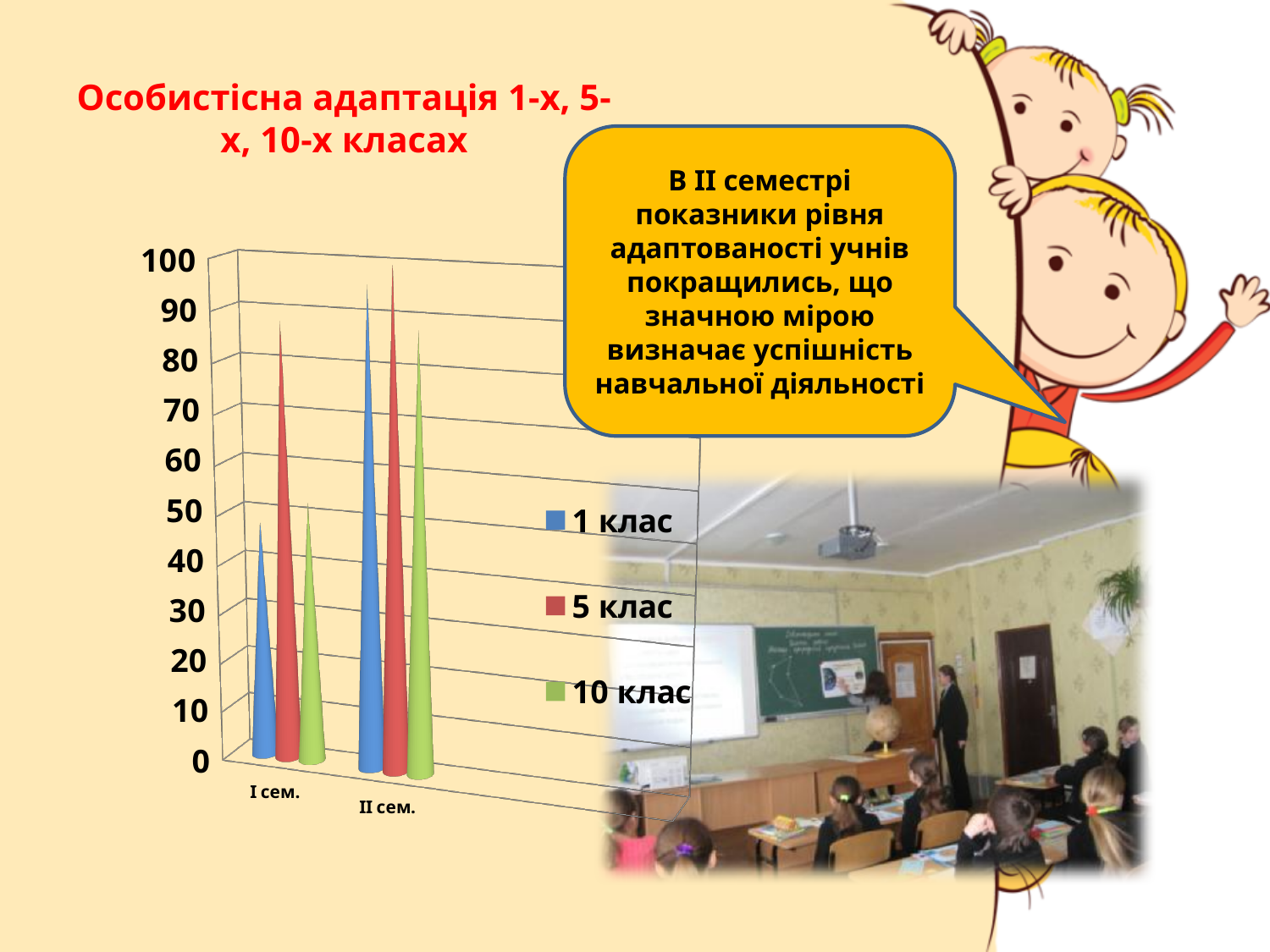
In I сем., which is larger: the value for 1 клас or the value for 5 клас? 5 клас What kind of chart is shown on the slide? bar chart Is the value for 1 клас in II сем. greater or less than 80? greater Which series has the lowest value in II сем.? 10 клас Is the value for 5 клас in I сем. greater or less than 70? greater What are the three series listed in the chart legend? 1 клас, 5 клас, 10 клас Which series has the highest value in I сем.? 5 клас Is the value for 1 клас in I сем. greater or less than 60? less Do the values for 1 клас rise or fall from I сем. to II сем.? rise How many categories are shown on the x axis of the chart? 2 How many series does the chart legend list? 3